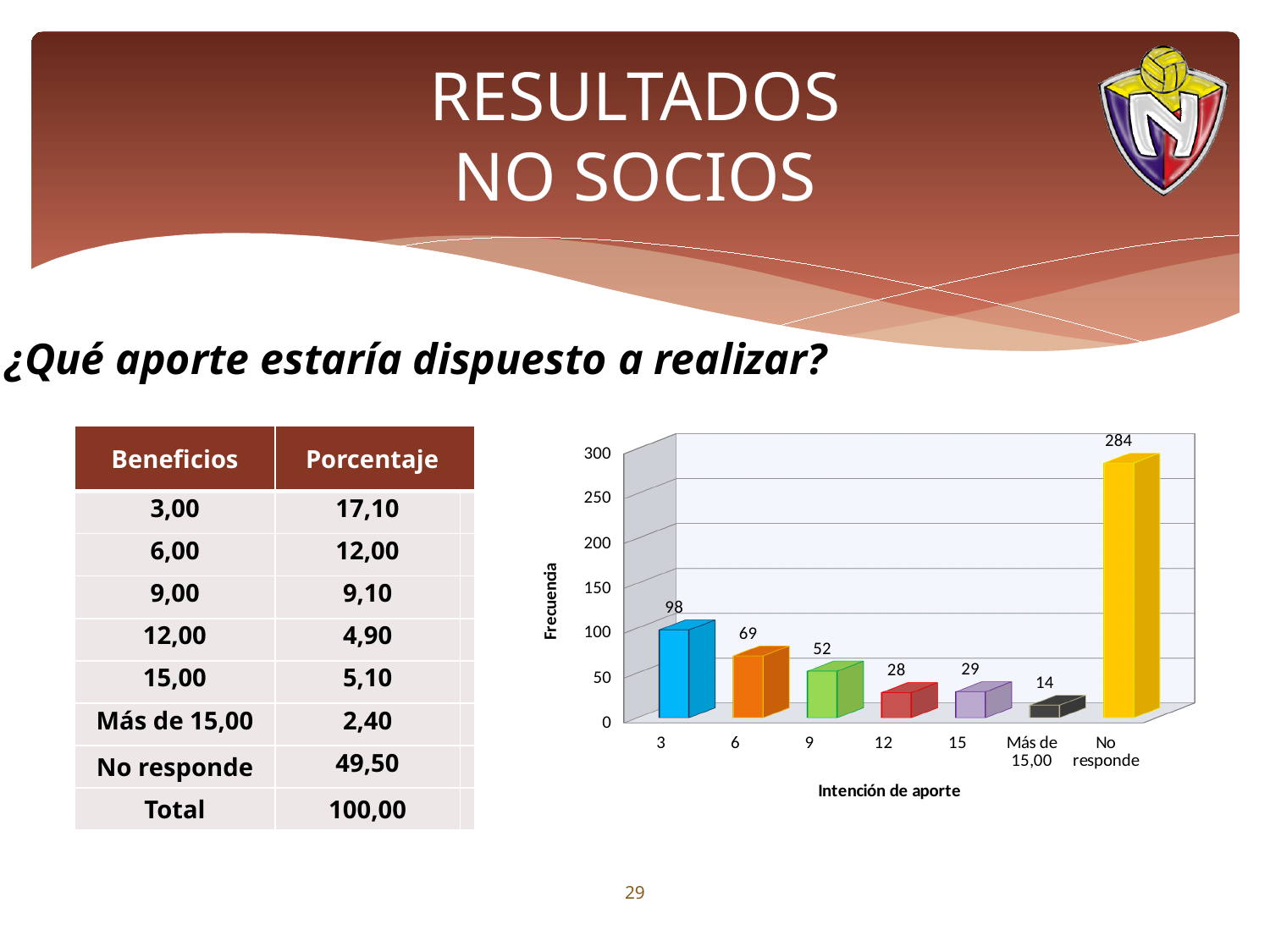
Which category has the highest frequency in the bar chart? No responde How many categories are shown on the x axis of the bar chart? 7 What is the frequency for the category 'No responde' in the bar chart? 284 What is the label of the x axis of the chart? Intención de aporte Is the frequency for category 9 greater or less than 100? less What is the frequency for the category 'Más de 15,00' in the bar chart? 14 What is the label of the y axis of the chart? Frecuencia What is the difference in frequency between category 3 and category 6? 29 What is the frequency for the category 3 in the bar chart? 98 Which category has the lowest frequency in the bar chart? Más de 15,00 What kind of chart is shown on the slide? bar chart Which has a higher frequency, category 12 or category 15? 15